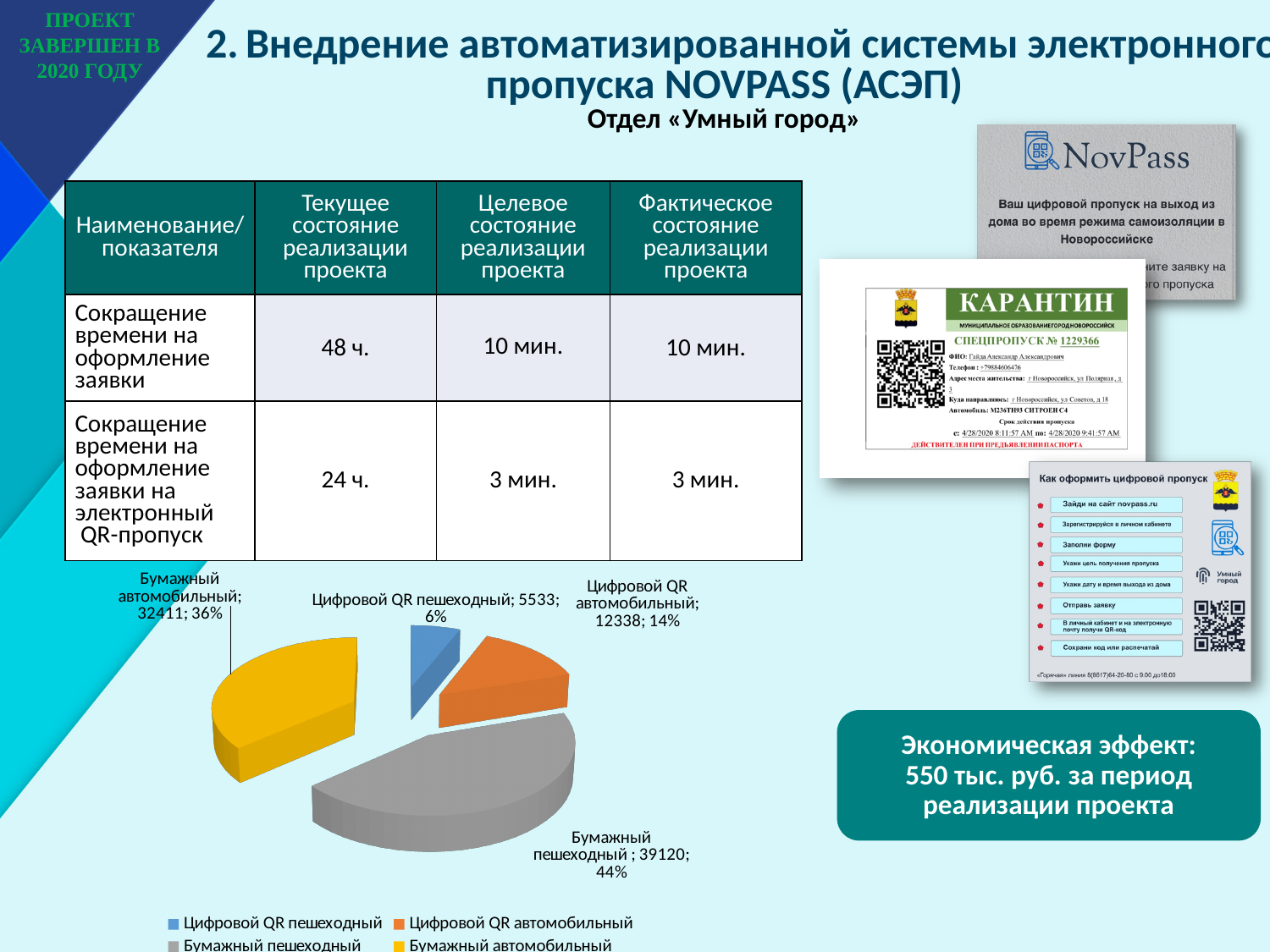
Which category has the largest slice in the pie chart? Бумажный пешеходный How many slices does the pie chart have? 4 How many entries does the pie chart legend list? 4 Which category has the smallest slice in the pie chart? Цифровой QR пешеходный What is the value for Бумажный автомобильный in the pie chart? 32411 What share of the pie does Бумажный автомобильный represent? 36% What kind of chart is shown at the bottom of the slide? Pie chart Which is larger in the pie chart: Цифровой QR автомобильный or Цифровой QR пешеходный? Цифровой QR автомобильный What is the value for Цифровой QR автомобильный in the pie chart? 12338 What share of the pie does Цифровой QR пешеходный represent? 6% What is the value for Бумажный пешеходный in the pie chart? 39120 What is the difference between the values for Бумажный пешеходный and Бумажный автомобильный? 6709